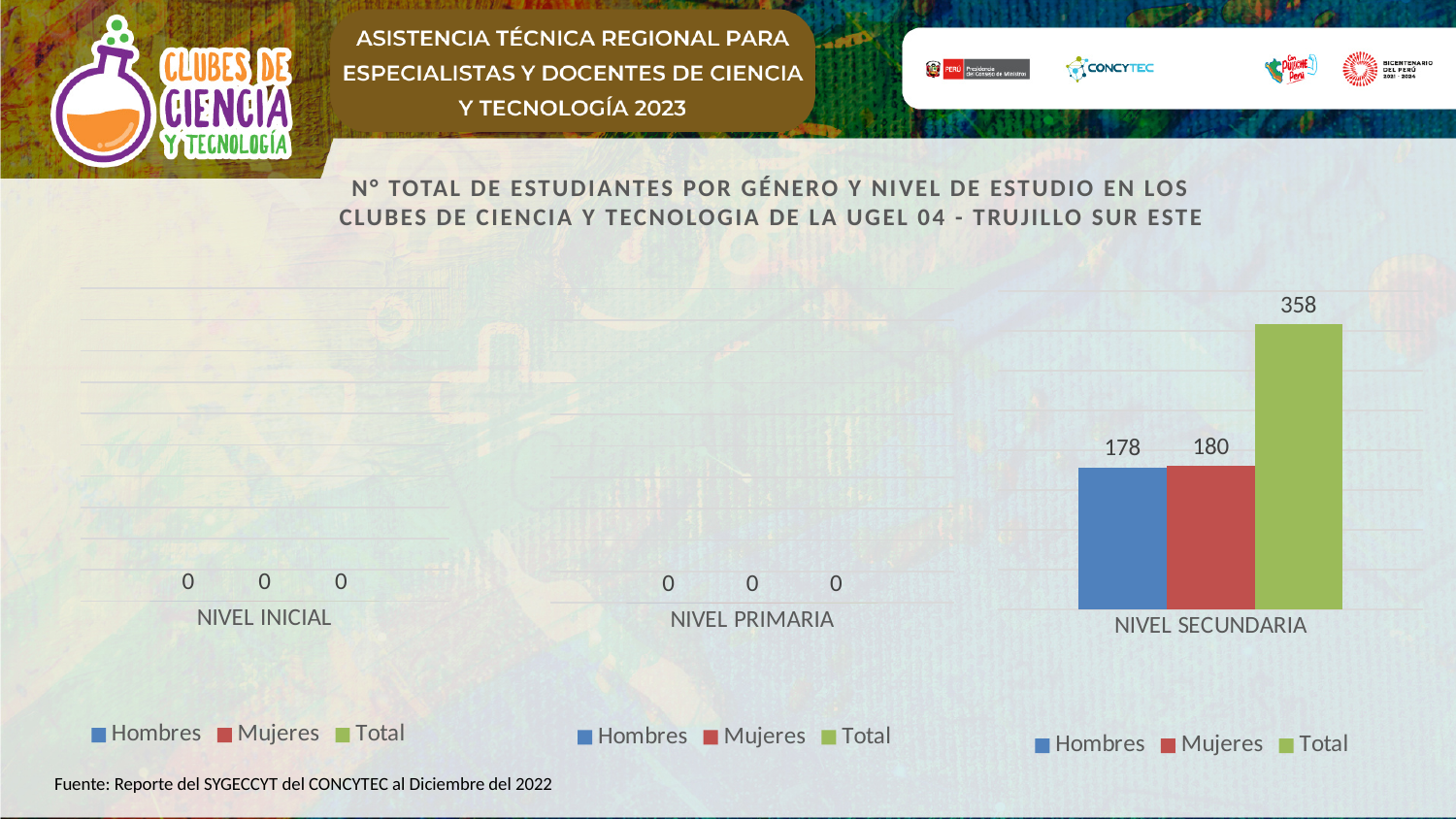
What is the value for Hombres at NIVEL SECUNDARIA? 178 What is the Total value at NIVEL SECUNDARIA? 358 What is the value for Mujeres at NIVEL SECUNDARIA? 180 What kind of chart is shown on the slide? Bar chart How many levels of study are shown on the x axis? 3 Which level has the highest Total value? NIVEL SECUNDARIA What is the difference between Mujeres and Hombres at NIVEL SECUNDARIA? 2 What is the Total value at NIVEL INICIAL? 0 How many series does the legend list? 3 What is the value for Hombres at NIVEL PRIMARIA? 0 At NIVEL SECUNDARIA, which is larger, Hombres or Mujeres? Mujeres Which colour represents the Total series in the legend? Green